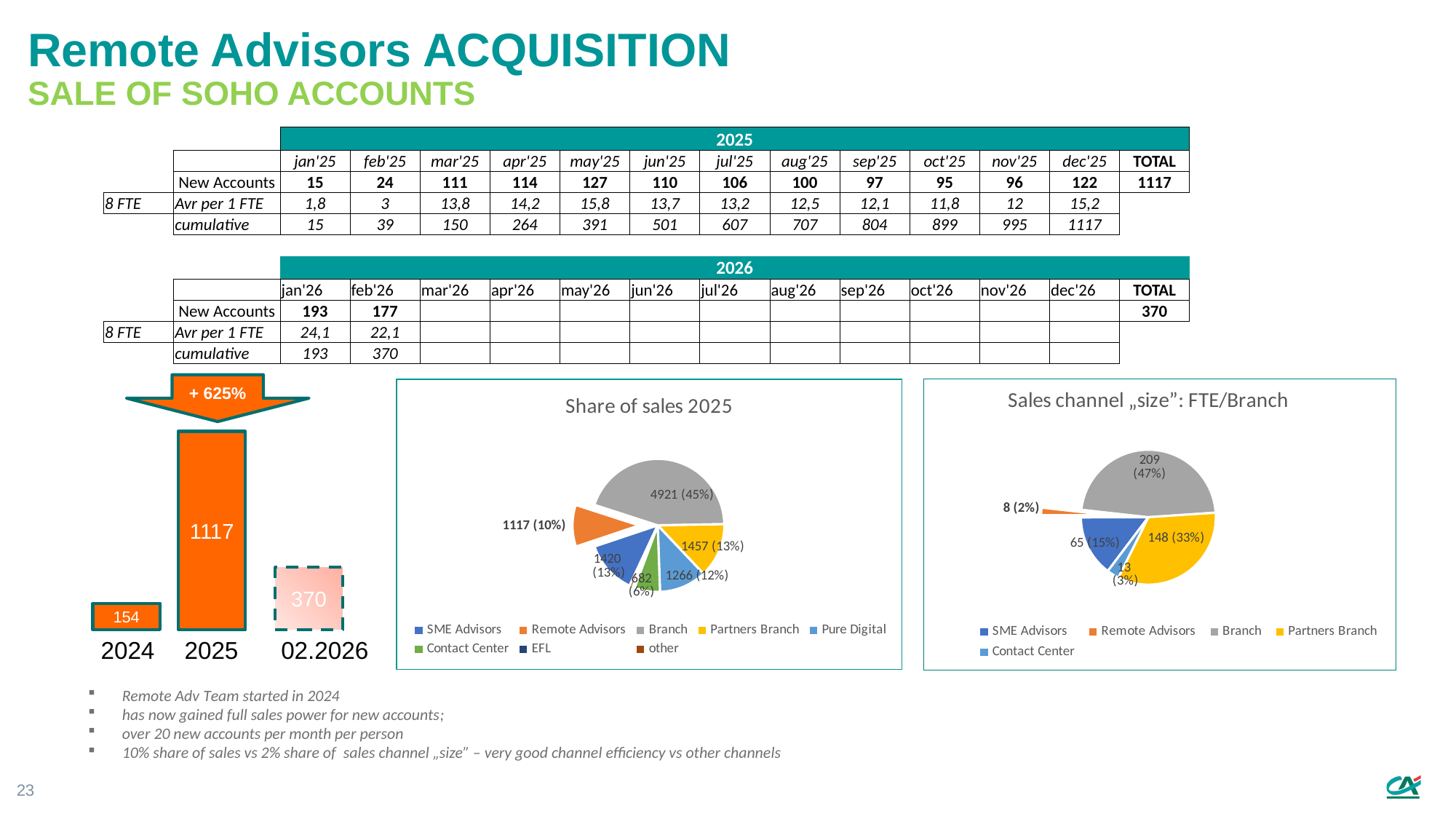
What type of chart is the chart on the left showing 2024, 2025 and 02.2026? Bar chart In the bar chart on the left, how many bars are shown? 3 In the 'Share of sales 2025' pie chart, what value is shown for Branch? 4921 (45%) In the bar chart on the left, what is the difference between the 2025 value and the 2024 value? 963 In the 'Share of sales 2025' pie chart, which channel has the largest slice? Branch In the 'Share of sales 2025' pie chart, what share of sales do Remote Advisors have? 10% In the 'Sales channel „size": FTE/Branch' pie chart, what value is shown for Partners Branch? 148 (33%) In the 'Share of sales 2025' pie chart, how many entries does the legend list? 8 In the bar chart on the left, what is the value for 2025? 1117 In the bar chart on the left, what is the value for 2024? 154 In the 'Sales channel „size": FTE/Branch' pie chart, which channel has the smallest slice? Remote Advisors In the bar chart on the left, which year has the highest value? 2025